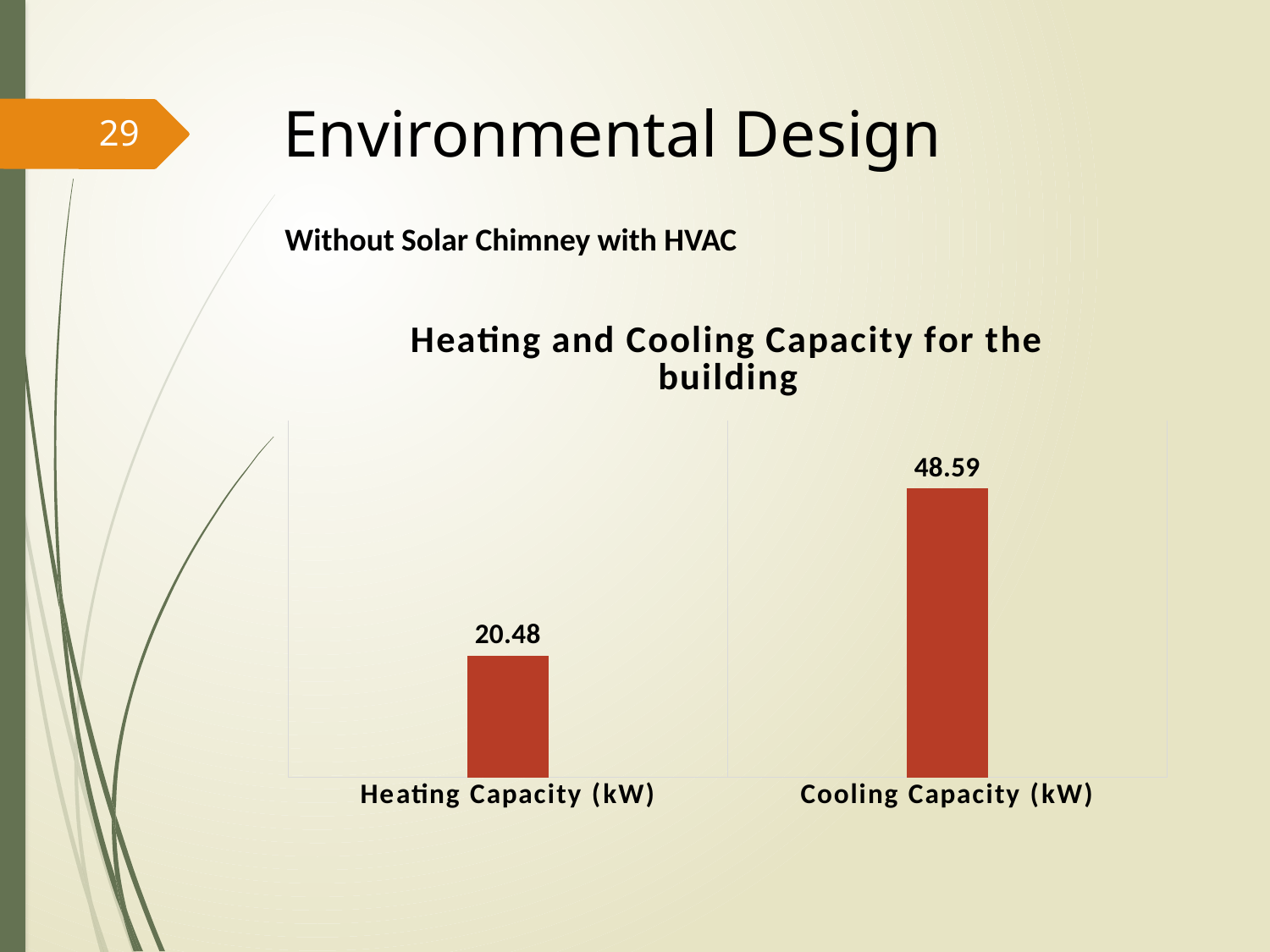
What is the total of the Heating Capacity and Cooling Capacity values? 69.07 What is the value for Cooling Capacity (kW)? 48.59 Which is larger, the Heating Capacity or the Cooling Capacity? Cooling Capacity What kind of chart is shown on the slide? Bar chart How many categories are shown in the chart? 2 What is the difference between the Cooling Capacity and the Heating Capacity values? 28.11 Which category has the lowest value? Heating Capacity (kW) What colour are the bars in the chart? Red What is the value for Heating Capacity (kW)? 20.48 Which category has the highest value? Cooling Capacity (kW) What is the title of the chart? Heating and Cooling Capacity for the building